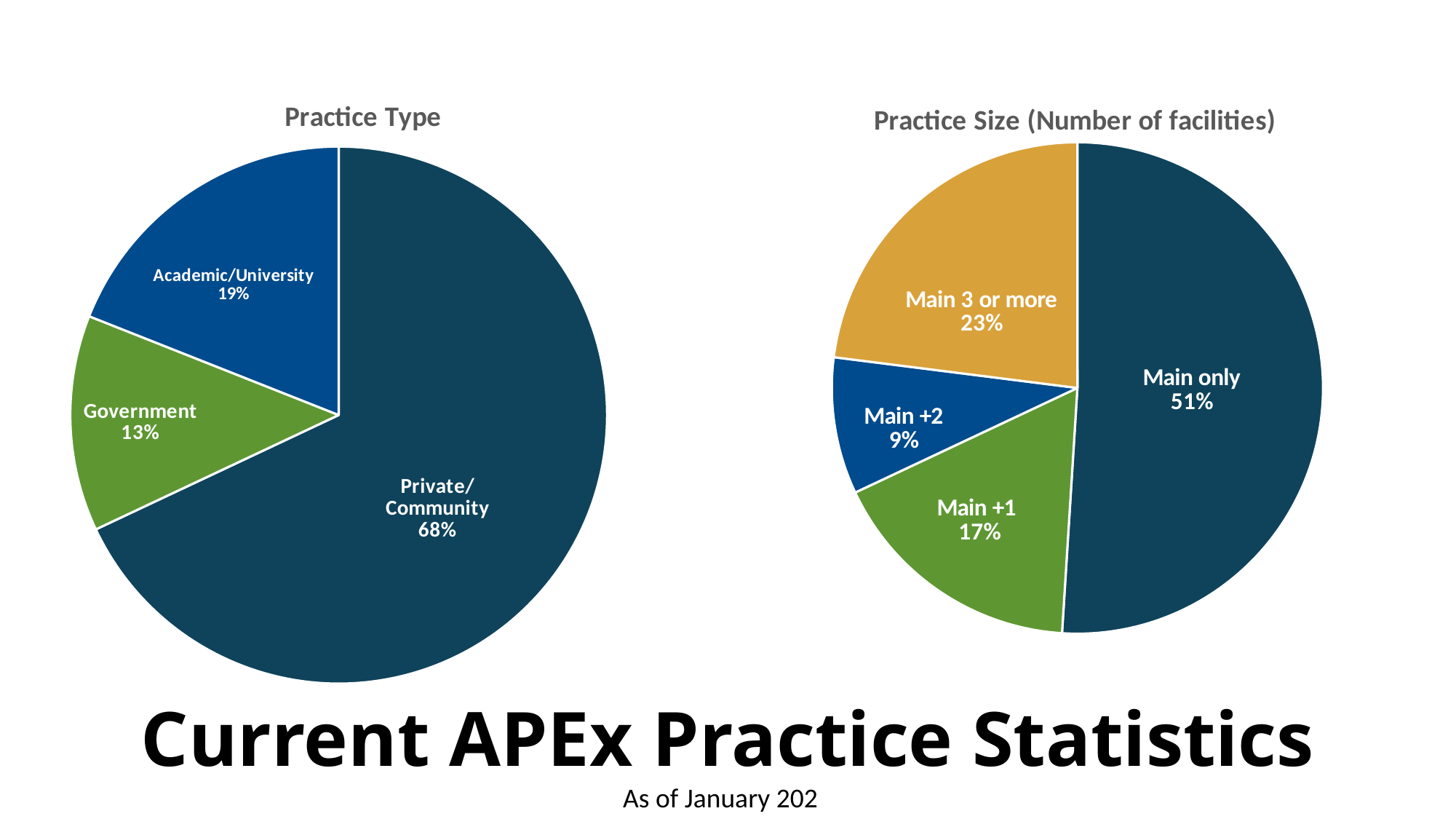
In the Practice Type chart, how many slices are there? 3 In the Practice Size (Number of facilities) chart, which category has the largest share? Main only In the Practice Size (Number of facilities) chart, which is larger, Main 3 or more or Main +1? Main 3 or more In the Practice Size (Number of facilities) chart, how many slices are there? 4 What kind of chart is the Practice Type chart? Pie chart In the Practice Size (Number of facilities) chart, what share is Main only? 51% In the Practice Type chart, what share is Private/Community? 68% In the Practice Type chart, what share is Government? 13% In the Practice Type chart, which category has the smallest share? Government In the Practice Size (Number of facilities) chart, what share is Main +2? 9% In the Practice Size (Number of facilities) chart, what colour is the Main 3 or more slice? Gold In the Practice Type chart, what is the difference between the Academic/University and Government shares? 6%